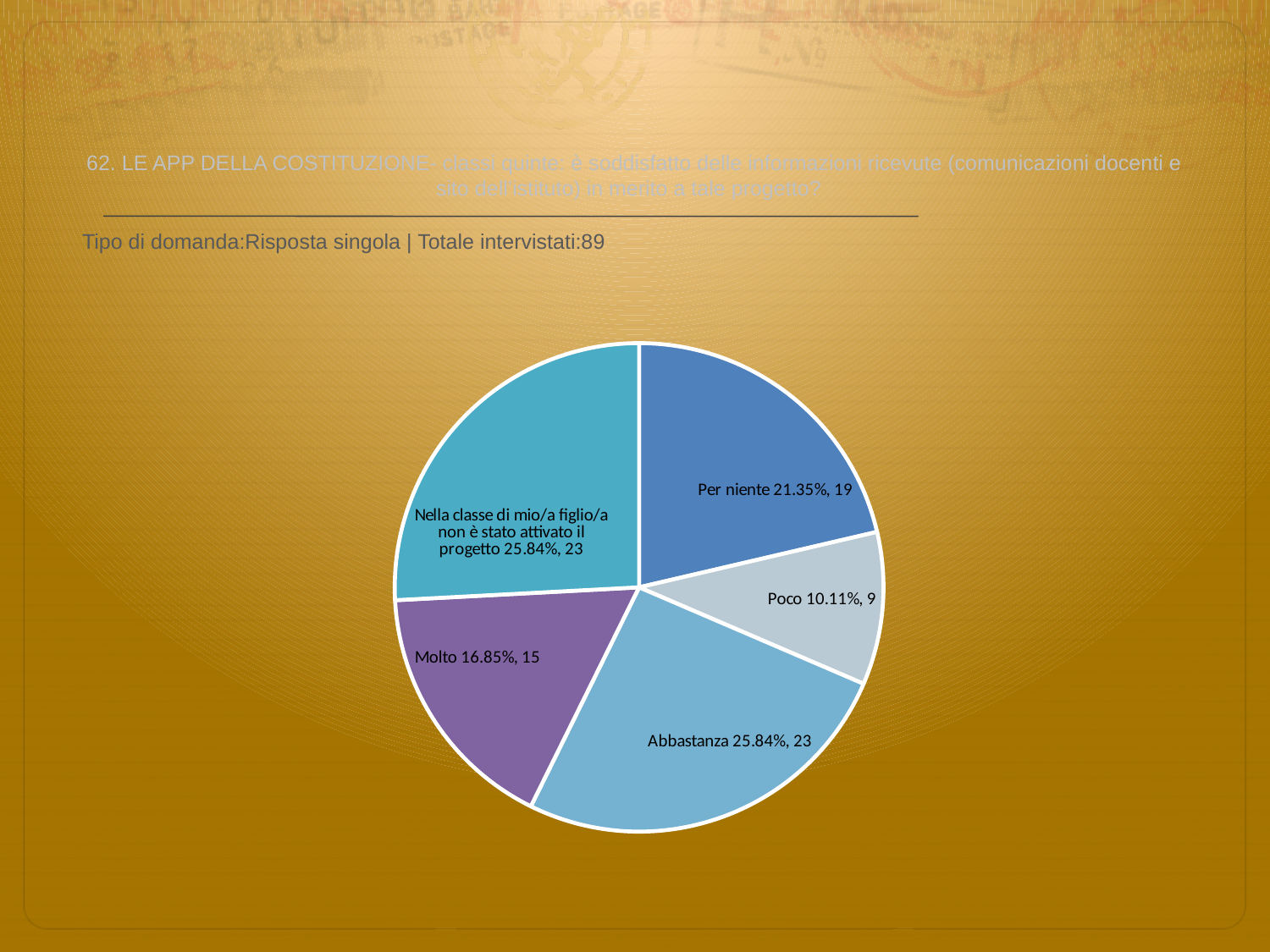
Which is larger, the 'Per niente' slice or the 'Molto' slice? Per niente According to the text above the chart, what is the total number of respondents (Totale intervistati)? 89 Which category has the smallest slice of the pie? Poco What percentage share does the 'Per niente' slice have? 21.35% What is the difference in respondent count between 'Abbastanza' and 'Poco'? 14 How many slices does the pie chart have? 5 What percentage share does the 'Molto' slice have? 16.85% How many respondents answered 'Nella classe di mio/a figlio/a non è stato attivato il progetto'? 23 How many respondents answered 'Abbastanza'? 23 What is the difference in respondent count between 'Per niente' and 'Molto'? 4 How many respondents answered 'Poco'? 9 What kind of chart is shown on the slide? Pie chart